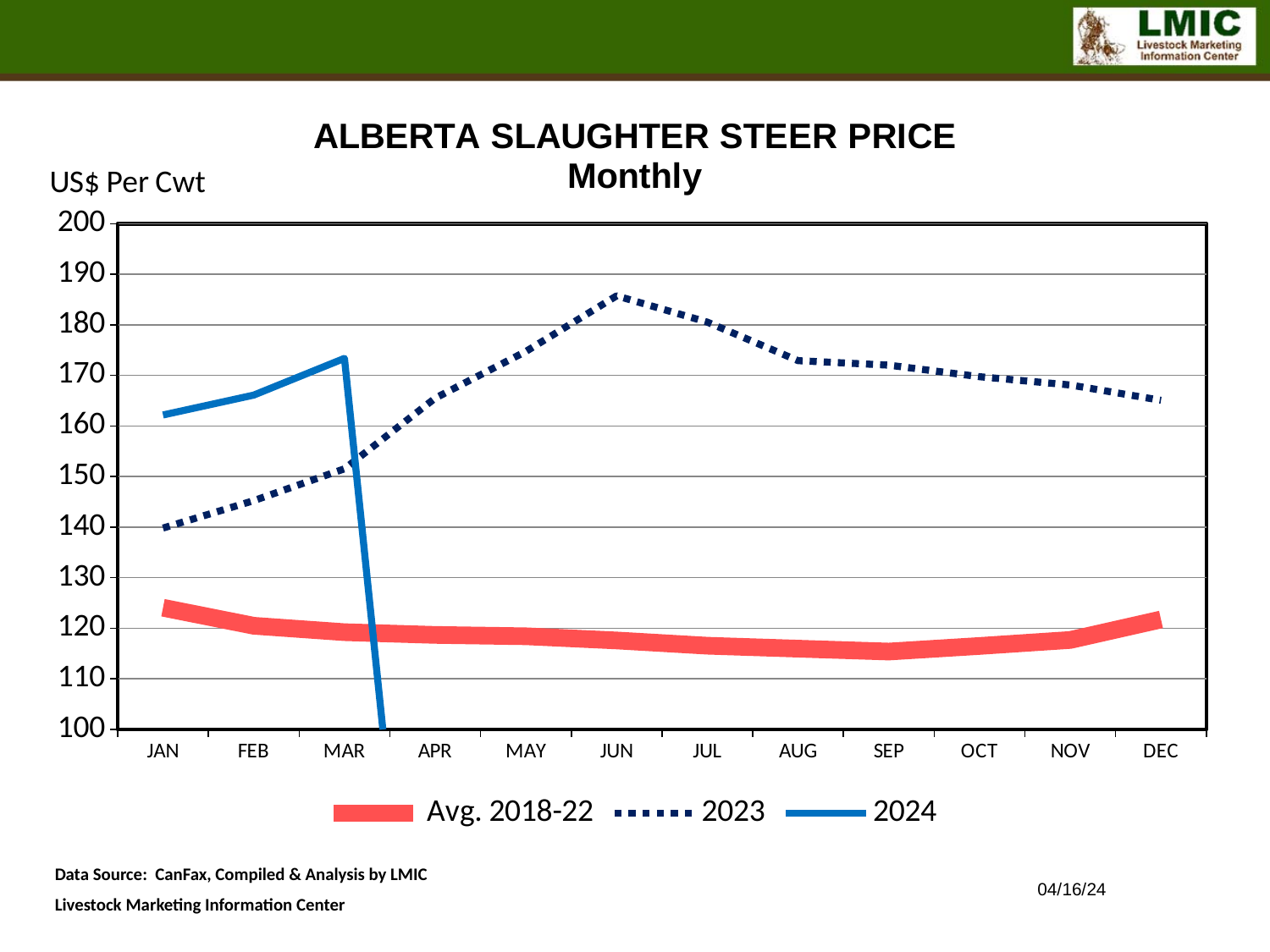
In which month is the 2023 series at its lowest value? JAN Is the Avg. 2018-22 value for JAN greater or less than 130? less Which is higher in JAN, the 2023 series or the Avg. 2018-22 series? 2023 Does the 2023 series rise or fall from JAN to JUN? rise In which month does the 2023 series reach its highest value? JUN What unit is shown on the y axis label? US$ Per Cwt Is the 2023 value for JAN greater or less than 150? less How many months are shown on the x axis? 12 Is the 2023 value for JUN greater or less than 180? greater What kind of chart is shown on the slide? line chart How many series does the legend list? 3